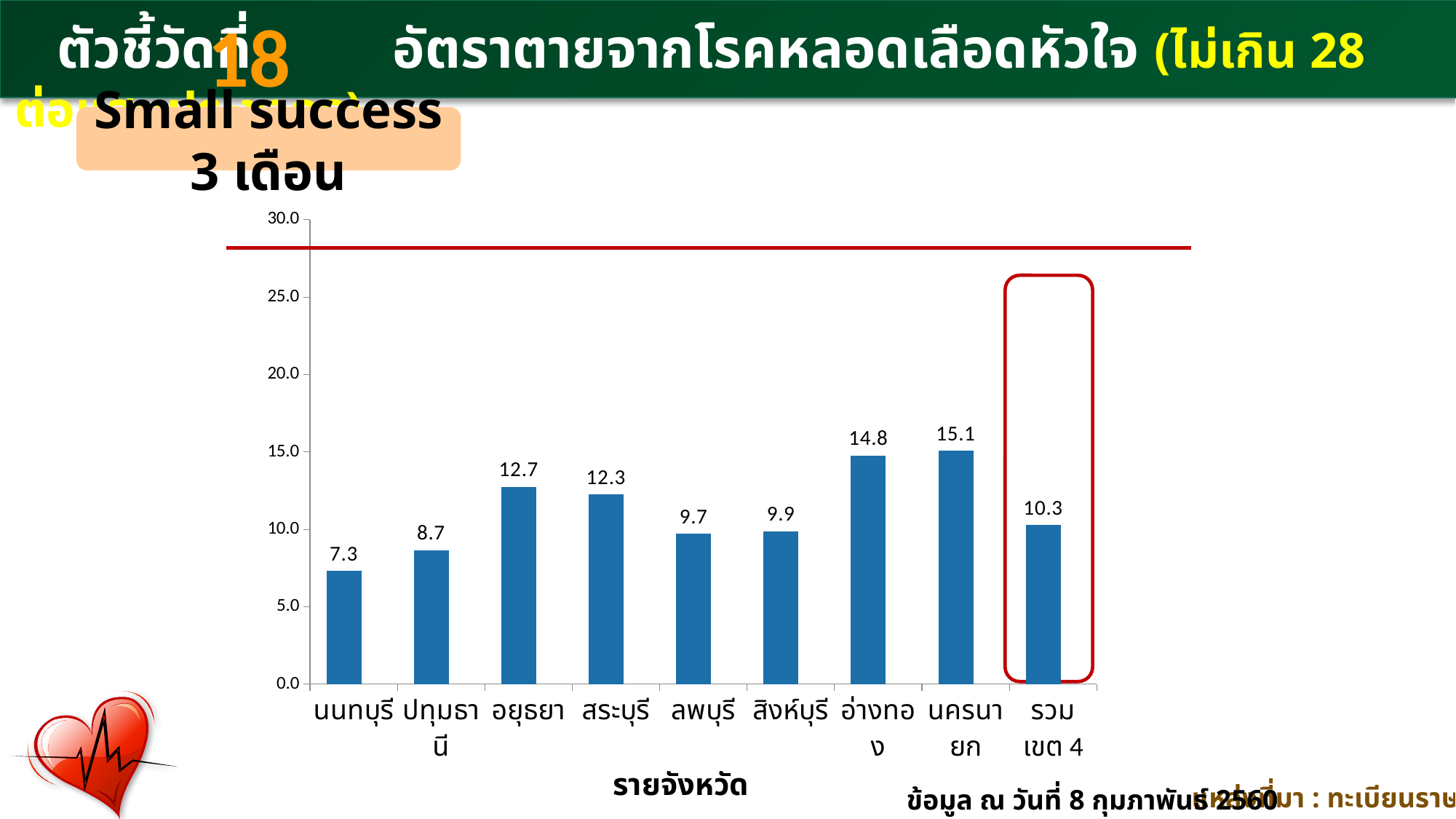
What is the value for นนทบุรี? 7.3 What is the value for อ่างทอง? 14.8 How many bars are plotted in the chart? 9 Is the value for สิงห์บุรี greater or less than 10.0? less Which category has the lowest value? นนทบุรี What is the difference between the values for นครนายก and นนทบุรี? 7.8 Which category has the highest value? นครนายก What kind of chart is shown on the slide? bar chart Which is larger, the value for ปทุมธานี or the value for ลพบุรี? ลพบุรี What is the value for รวมเขต 4? 10.3 What is the difference between the values for อยุธยา and สระบุรี? 0.4 What is the x-axis title of the chart? รายจังหวัด